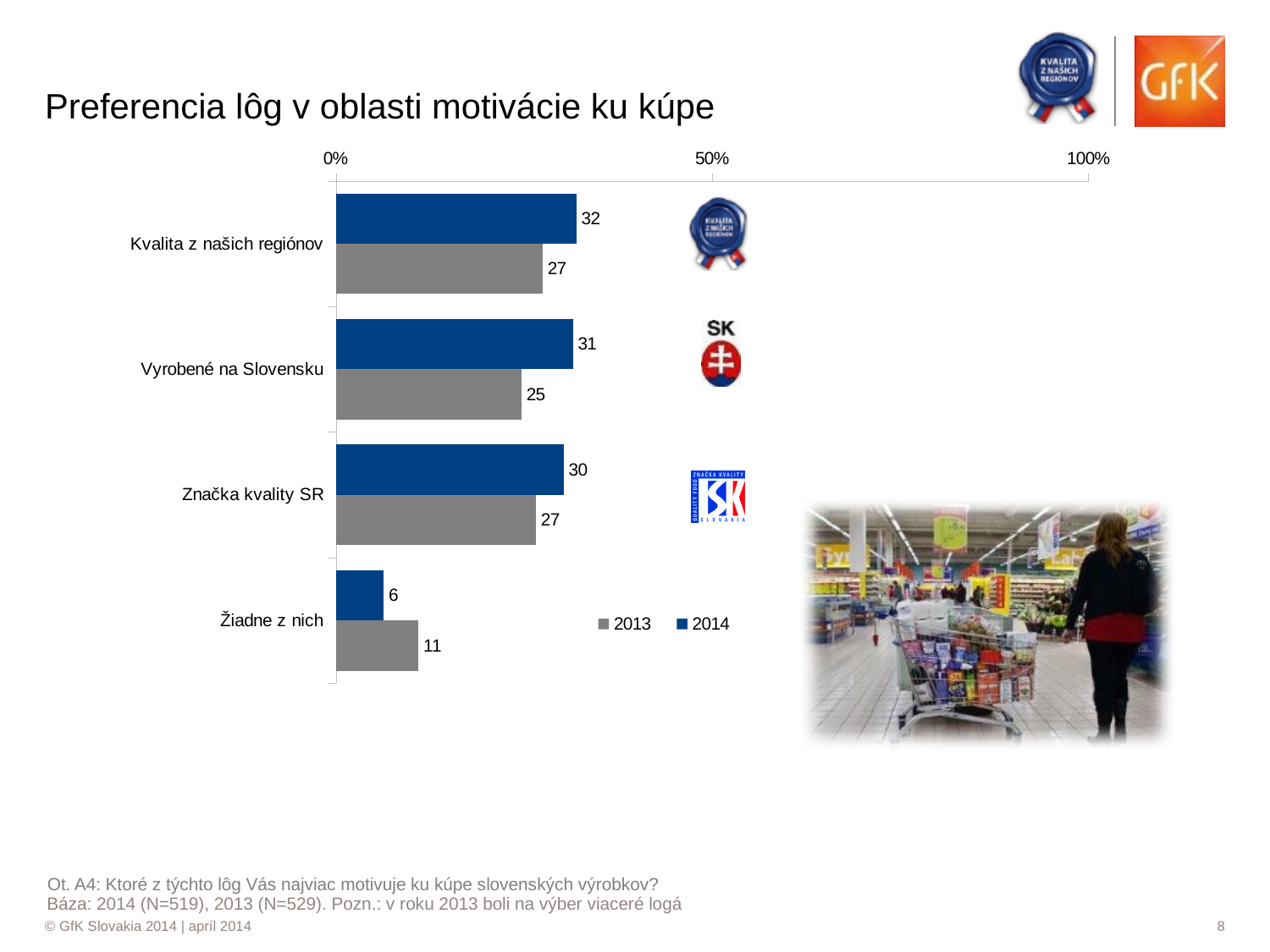
Which is larger for Žiadne z nich, the 2013 value or the 2014 value? 2013 Which category has the lowest 2013 value? Žiadne z nich What is the difference between the 2014 and 2013 values for Vyrobené na Slovensku? 6 What is the 2014 value for Kvalita z našich regiónov? 32 What is the 2013 value for Žiadne z nich? 11 How many series does the legend list? 2 How many categories are shown on the chart? 4 What kind of chart is shown on the slide? bar chart What is the 2013 value for Vyrobené na Slovensku? 25 Is the 2014 value for Značka kvality SR greater or less than 50%? less Which category has the highest 2014 value? Kvalita z našich regiónov What is the title of the chart? Preferencia lôg v oblasti motivácie ku kúpe